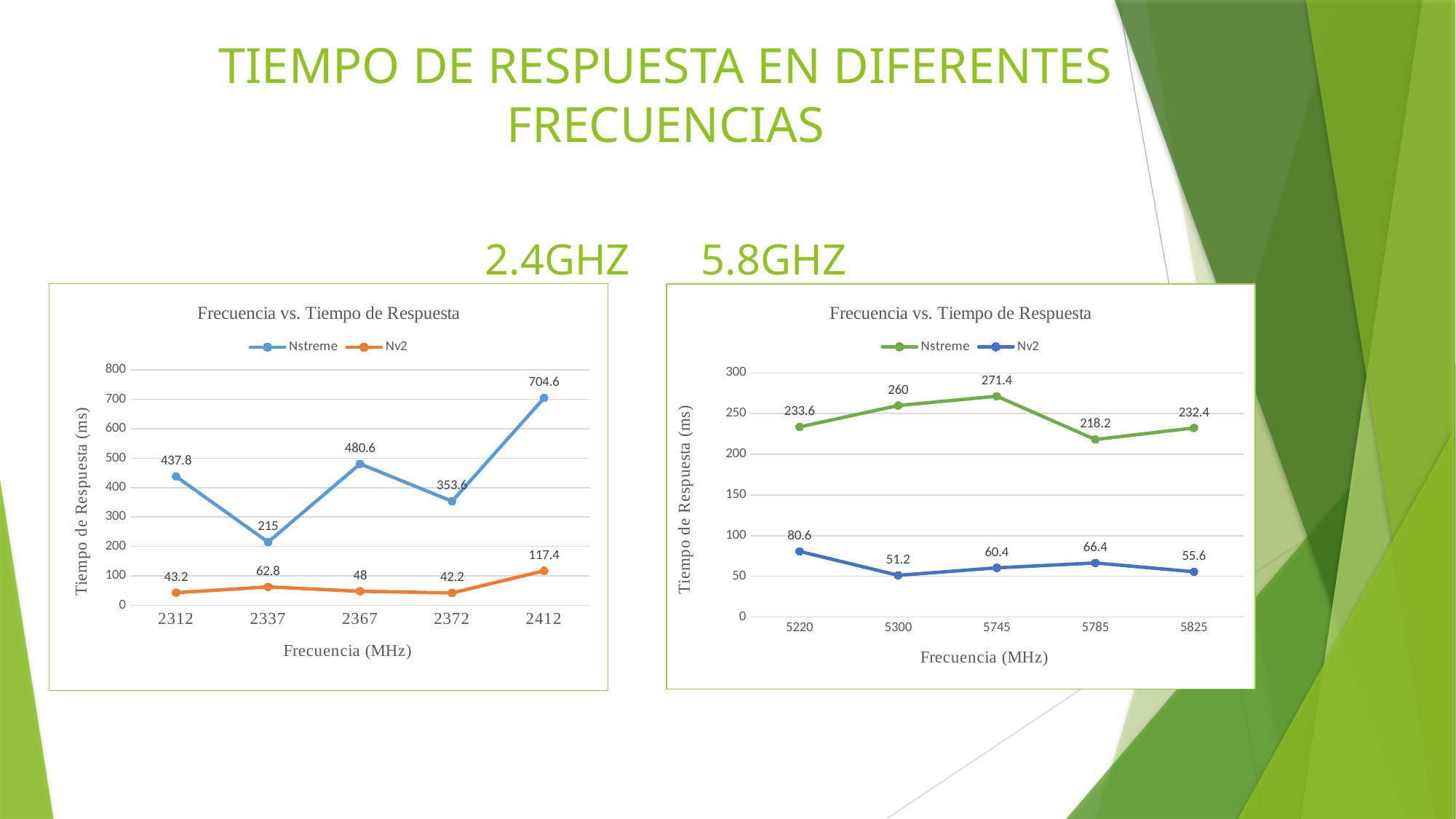
In the 5.8GHZ chart on the right, at which frequency is the Nv2 response time lowest? 5300 In the 5.8GHZ chart on the right, what is the Nv2 response time at 5220 MHz? 80.6 In the 2.4GHZ chart on the left, what is the difference between the Nstreme and Nv2 values at 2312 MHz? 394.6 In the 5.8GHZ chart on the right, what is the Nstreme response time at 5745 MHz? 271.4 In the 2.4GHZ chart on the left, how many series does the legend list? 2 In the 5.8GHZ chart on the right, how many frequency points are plotted on the x axis? 5 In the 2.4GHZ chart on the left, what is the Nstreme response time at 2412 MHz? 704.6 What type of chart is the 2.4GHZ chart on the left? Line chart In the 5.8GHZ chart on the right, at which frequency is the Nstreme response time highest? 5745 In the 2.4GHZ chart on the left, at which frequency is the Nstreme response time lowest? 2337 In the 2.4GHZ chart on the left, what is the Nv2 response time at 2337 MHz? 62.8 In the 5.8GHZ chart on the right, which is larger: the Nv2 value at 5785 MHz or at 5825 MHz? 5785 MHz